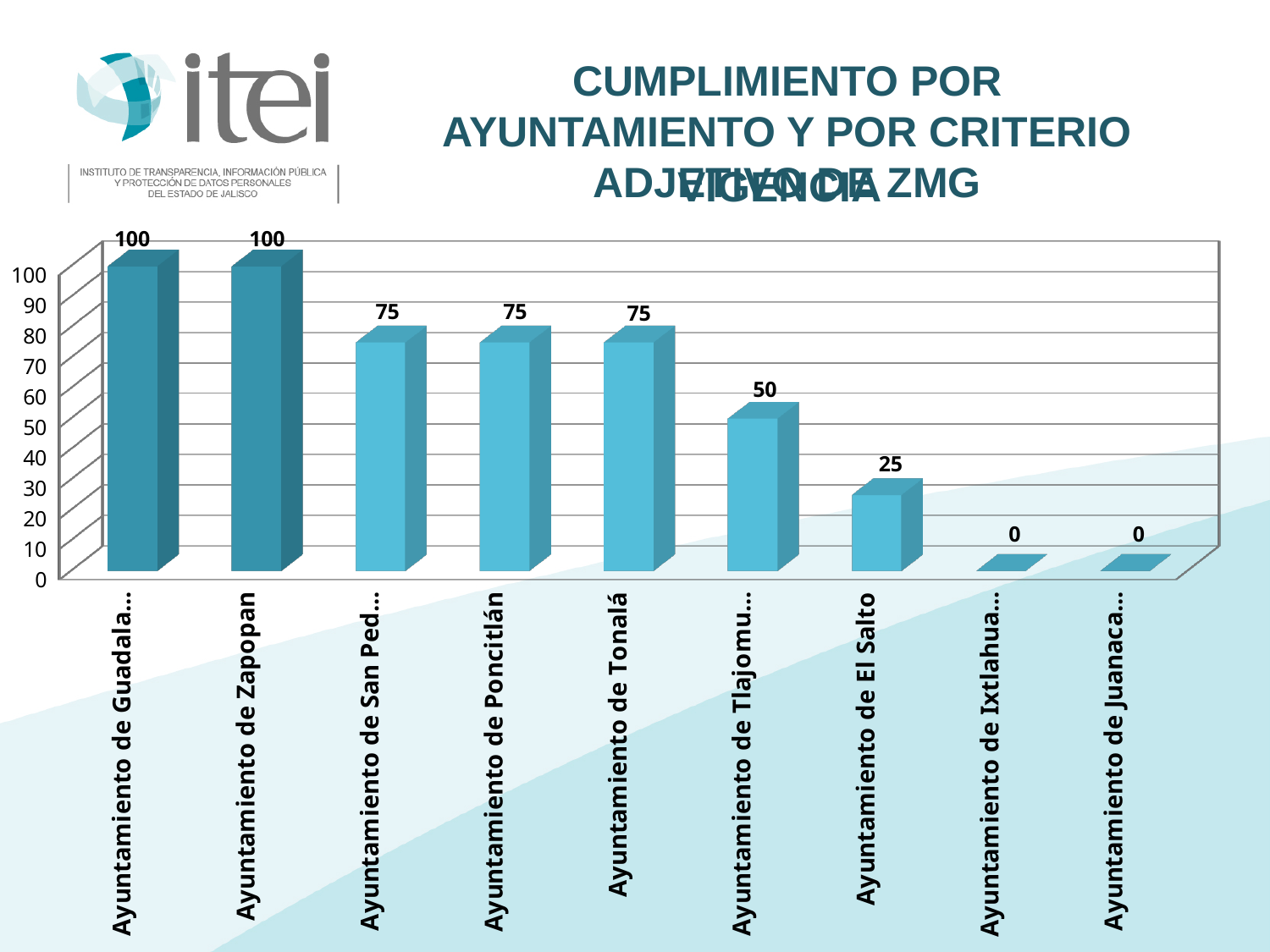
What is the value for Ayuntamiento de El Salto? 25 What is the value for Ayuntamiento de Poncitlán? 75 Do the values rise or fall from left to right across the chart? fall Which has a larger value, Ayuntamiento de Tonalá or Ayuntamiento de El Salto? Ayuntamiento de Tonalá How many bars have a value of 0? 2 What is the value for Ayuntamiento de Zapopan? 100 What is the value for Ayuntamiento de Tonalá? 75 How many categories (bars) are shown in the chart? 9 What is the difference between the values for Ayuntamiento de Zapopan and Ayuntamiento de El Salto? 75 Is the value for Ayuntamiento de Poncitlán greater or less than 50? greater What kind of chart is shown on the slide? bar chart What is the value of the sixth bar from the left? 50